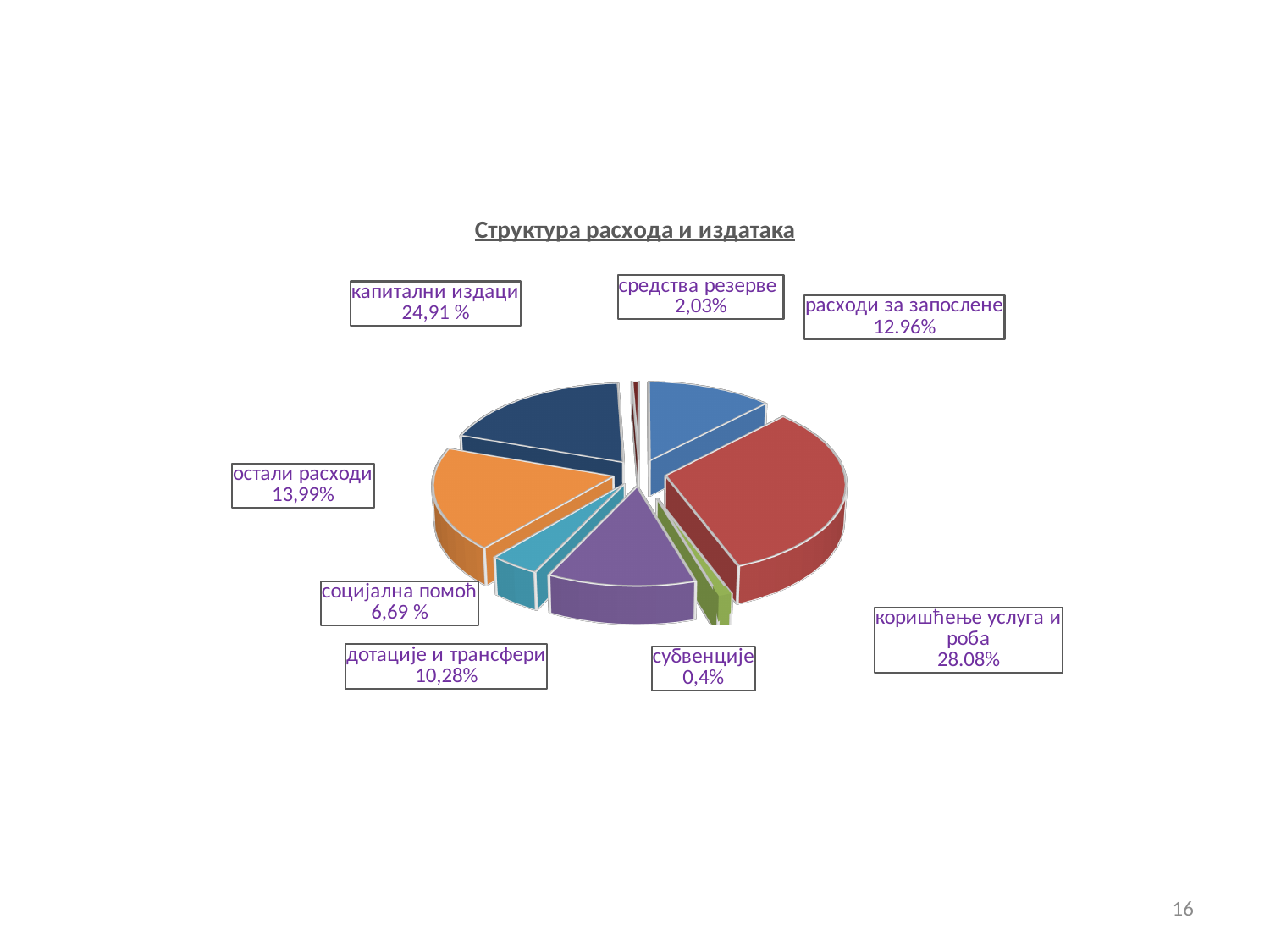
What share does субвенције have in the pie chart? 0,4% Which has a larger share: расходи за запослене or дотације и трансфери? расходи за запослене Which has a larger share: социјална помоћ or остали расходи? остали расходи What is the title of the chart? Структура расхода и издатака What share does остали расходи have in the pie chart? 13,99% Which category has the smallest share of the pie? субвенције What share does капитални издаци have in the pie chart? 24,91 % Which category has the largest share of the pie? коришћење услуга и роба What share does коришћење услуга и роба have in the pie chart? 28.08% What share does средства резерве have in the pie chart? 2,03% What kind of chart is shown on the slide? pie chart How many categories does the pie chart show? 8